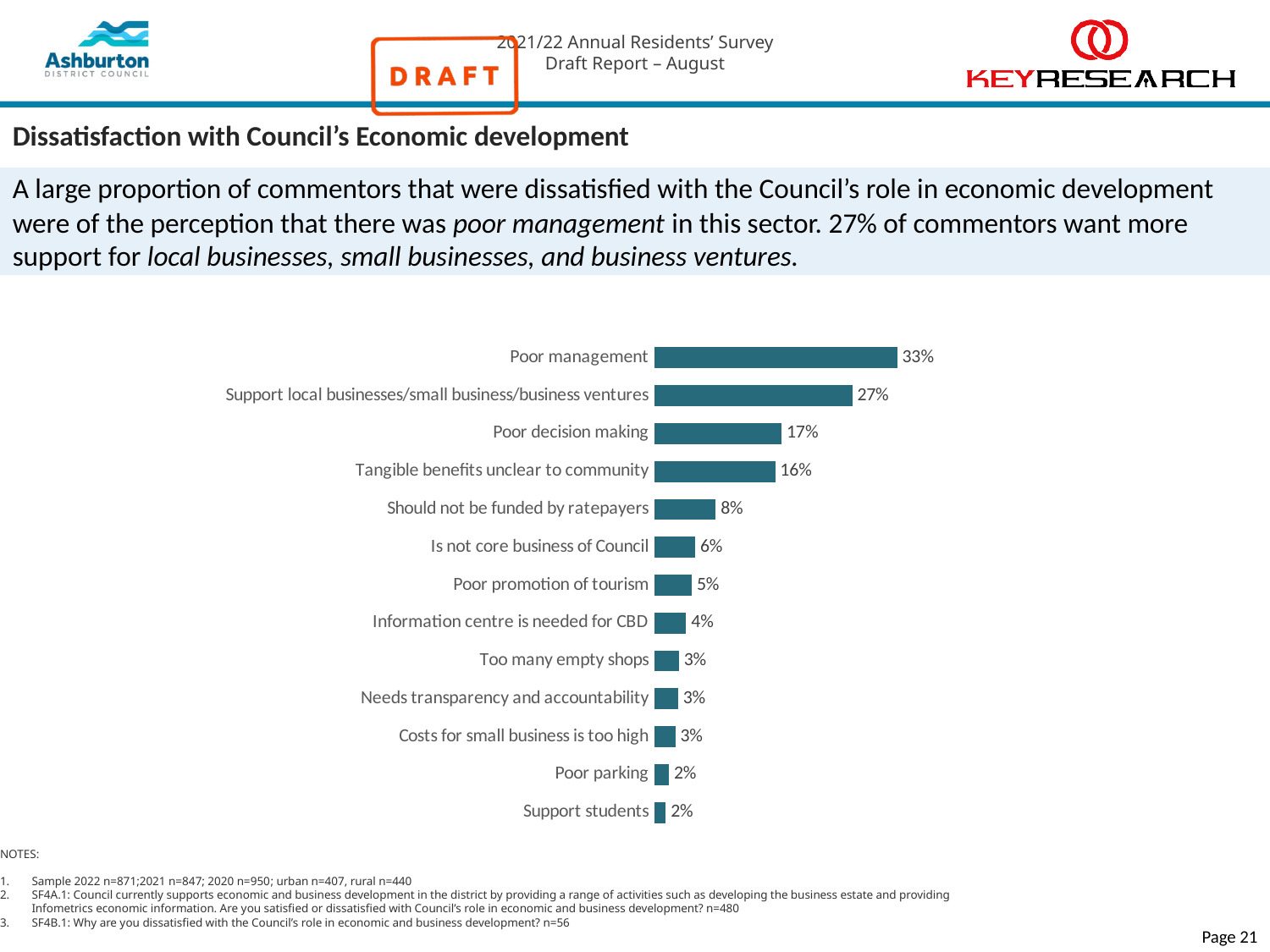
What is the difference between 'Poor management' and 'Support local businesses/small business/business ventures'? 6% What is the value for 'Too many empty shops'? 3% Which is larger: 'Poor decision making' or 'Tangible benefits unclear to community'? Poor decision making What kind of chart is shown on the slide? Bar chart What is the difference between 'Poor decision making' and 'Poor promotion of tourism'? 12% What is the value for 'Tangible benefits unclear to community'? 16% How many categories are shown in the chart? 13 Which category has the highest value in the chart? Poor management Which is larger: 'Is not core business of Council' or 'Information centre is needed for CBD'? Is not core business of Council What is the value for 'Support students'? 2% What percentage is shown for 'Should not be funded by ratepayers'? 8% What percentage of commentors cited 'Poor management'? 33%